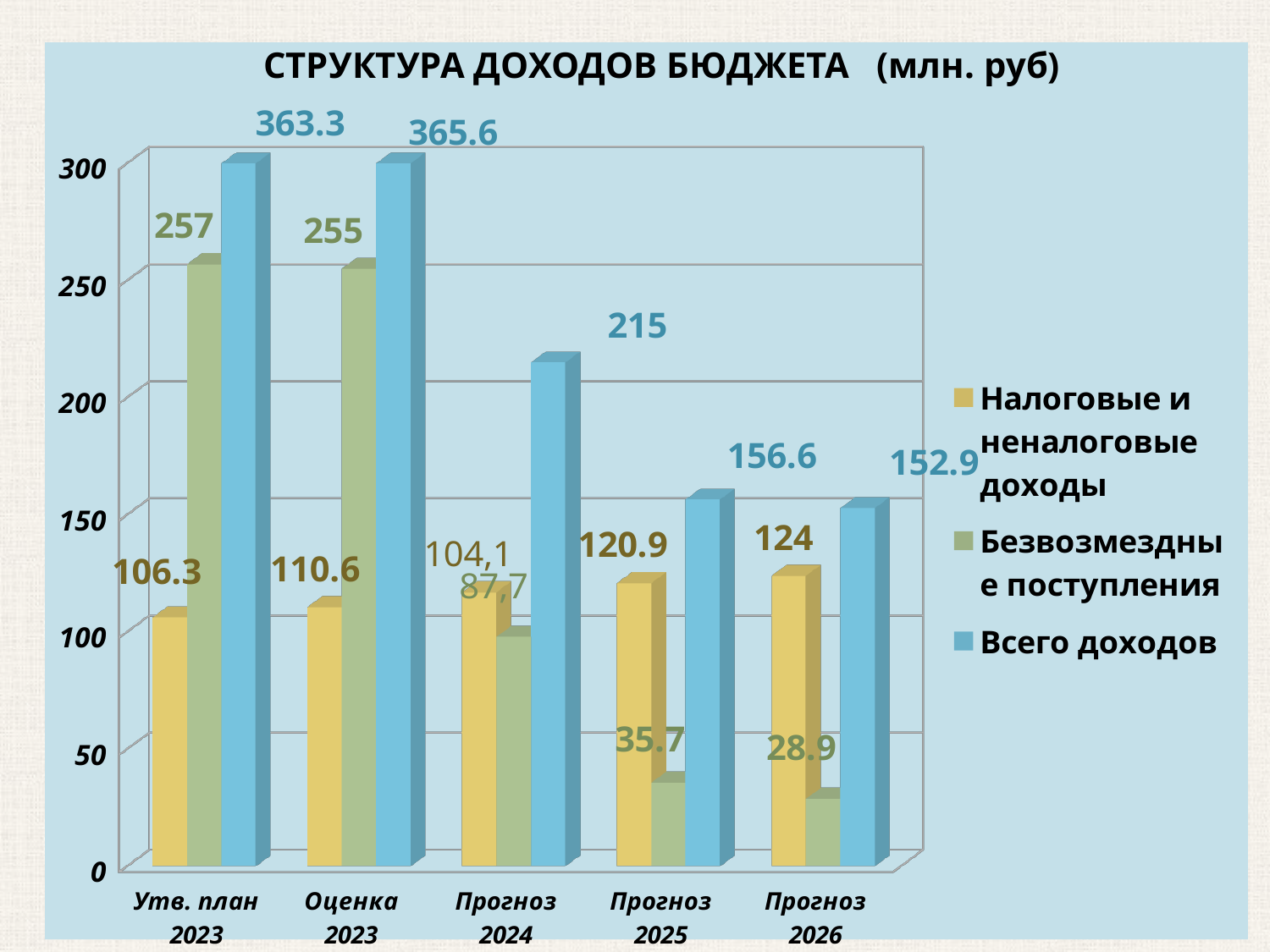
What type of chart is shown on the slide? Bar chart Which category has the highest value of Всего доходов? Оценка 2023 Do the values of Безвозмездные поступления rise or fall from Утв. план 2023 to Прогноз 2026? Fall Which category has the lowest value of Безвозмездные поступления? Прогноз 2026 How many series does the legend list? 3 What is the value of Всего доходов for Оценка 2023? 365.6 What is the value of Безвозмездные поступления for Прогноз 2024? 87,7 What is the title of the chart? СТРУКТУРА ДОХОДОВ БЮДЖЕТА (млн. руб) What is the value of Налоговые и неналоговые доходы for Прогноз 2025? 120.9 What is the difference between Всего доходов for Прогноз 2024 and Прогноз 2025? 58.4 How many categories are shown on the x axis? 5 Which is larger: Налоговые и неналоговые доходы for Утв. план 2023 or for Прогноз 2026? Прогноз 2026